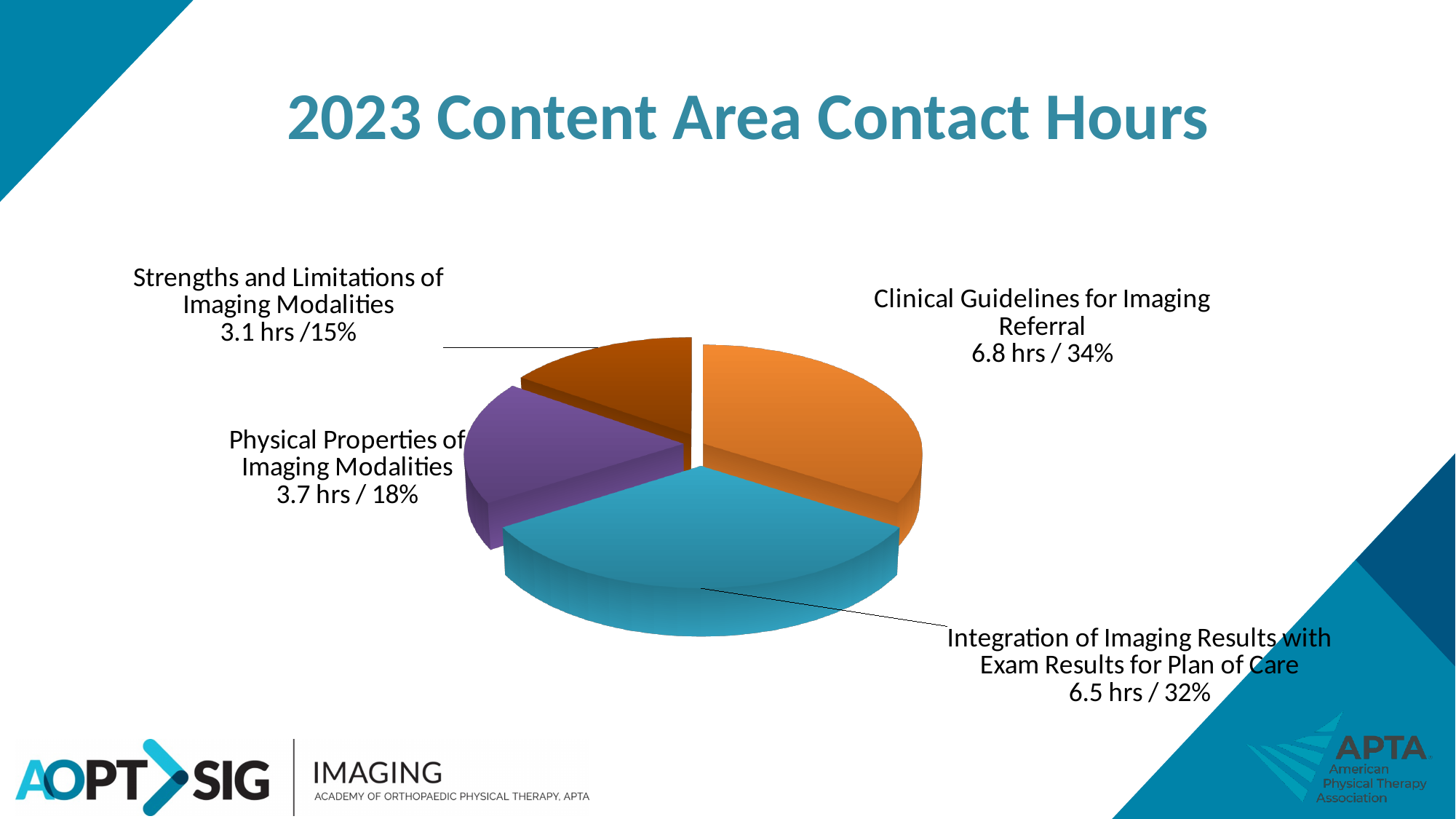
How many contact hours are shown for Strengths and Limitations of Imaging Modalities? 3.1 hrs Which content area has the fewest contact hours? Strengths and Limitations of Imaging Modalities What is the title of the chart? 2023 Content Area Contact Hours How many content areas are shown in the pie chart? 4 Which content area has the most contact hours? Clinical Guidelines for Imaging Referral What percentage share does Physical Properties of Imaging Modalities have? 18% What is the difference in contact hours between Clinical Guidelines for Imaging Referral and Integration of Imaging Results with Exam Results for Plan of Care? 0.3 hrs What type of chart is shown on the slide? Pie chart What colour is the slice for Integration of Imaging Results with Exam Results for Plan of Care? Teal/blue Which has more contact hours: Physical Properties of Imaging Modalities or Strengths and Limitations of Imaging Modalities? Physical Properties of Imaging Modalities How many contact hours are shown for Clinical Guidelines for Imaging Referral? 6.8 hrs What percentage share does Integration of Imaging Results with Exam Results for Plan of Care have? 32%